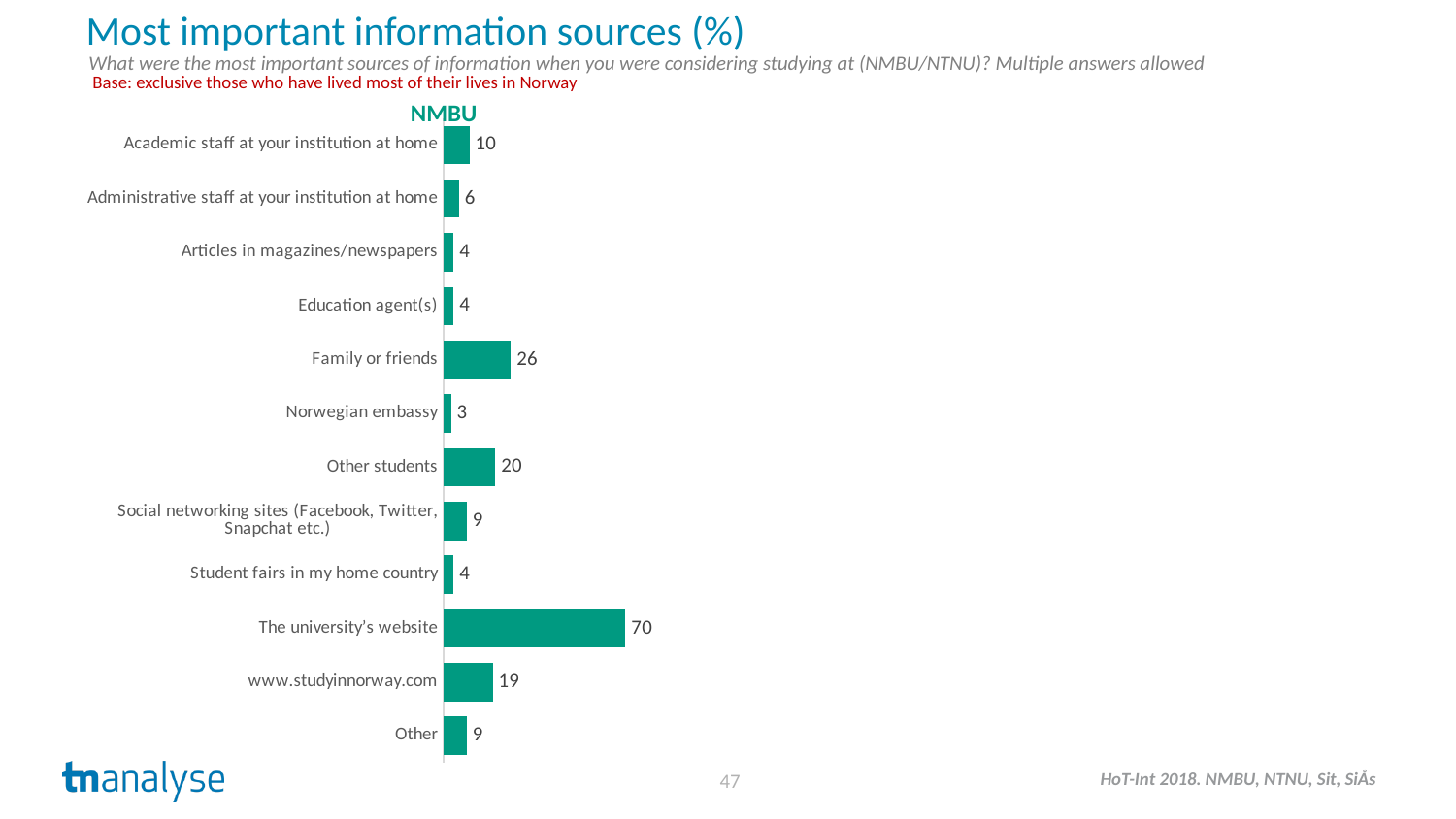
What kind of chart is shown on the slide? Bar chart What is the difference between 'Academic staff at your institution at home' and 'Administrative staff at your institution at home'? 4 How many categories are shown in the chart? 12 Which category has the highest value? The university's website What is the value for 'Norwegian embassy'? 3 What is the value for 'Family or friends'? 26 What is the value for 'The university's website'? 70 Which is larger, 'Other students' or 'www.studyinnorway.com'? Other students What is the difference between 'The university's website' and 'Family or friends'? 44 Which category has the lowest value? Norwegian embassy Which institution is the chart labelled for? NMBU What is the value for 'www.studyinnorway.com'? 19